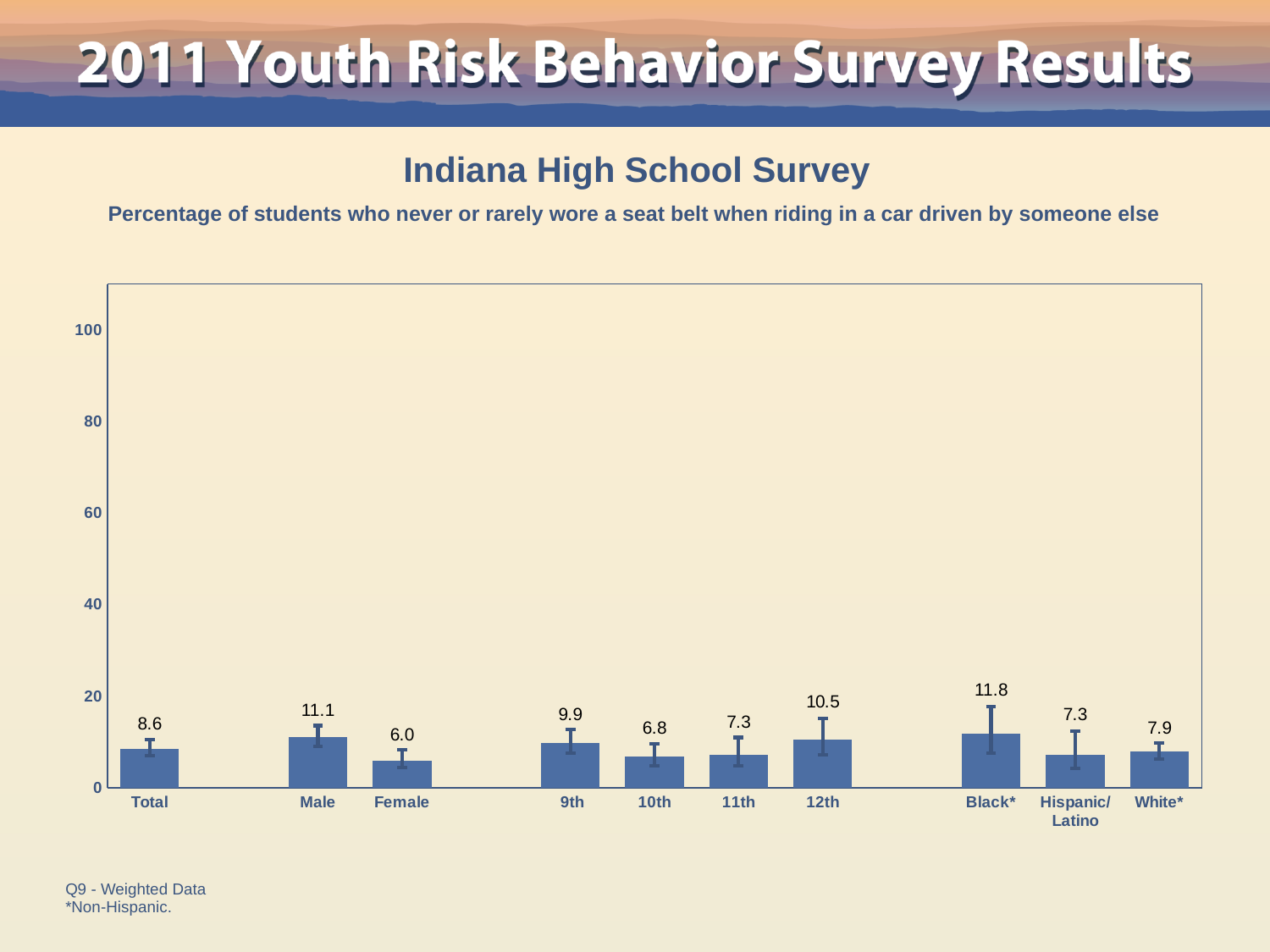
Is the value for Black* greater or less than 20? less Which category has the highest value? Black* What kind of chart is this? bar chart What is the value for Total? 8.6 How many categories are shown on the x axis? 10 What is the title of the chart? Indiana High School Survey Which category has the lowest value? Female What is the value for Female? 6.0 What is the value for 12th? 10.5 Which is larger, the value for 9th or the value for 10th? 9th What is the value for Hispanic/Latino? 7.3 What is the difference between the values for Male and Female? 5.1